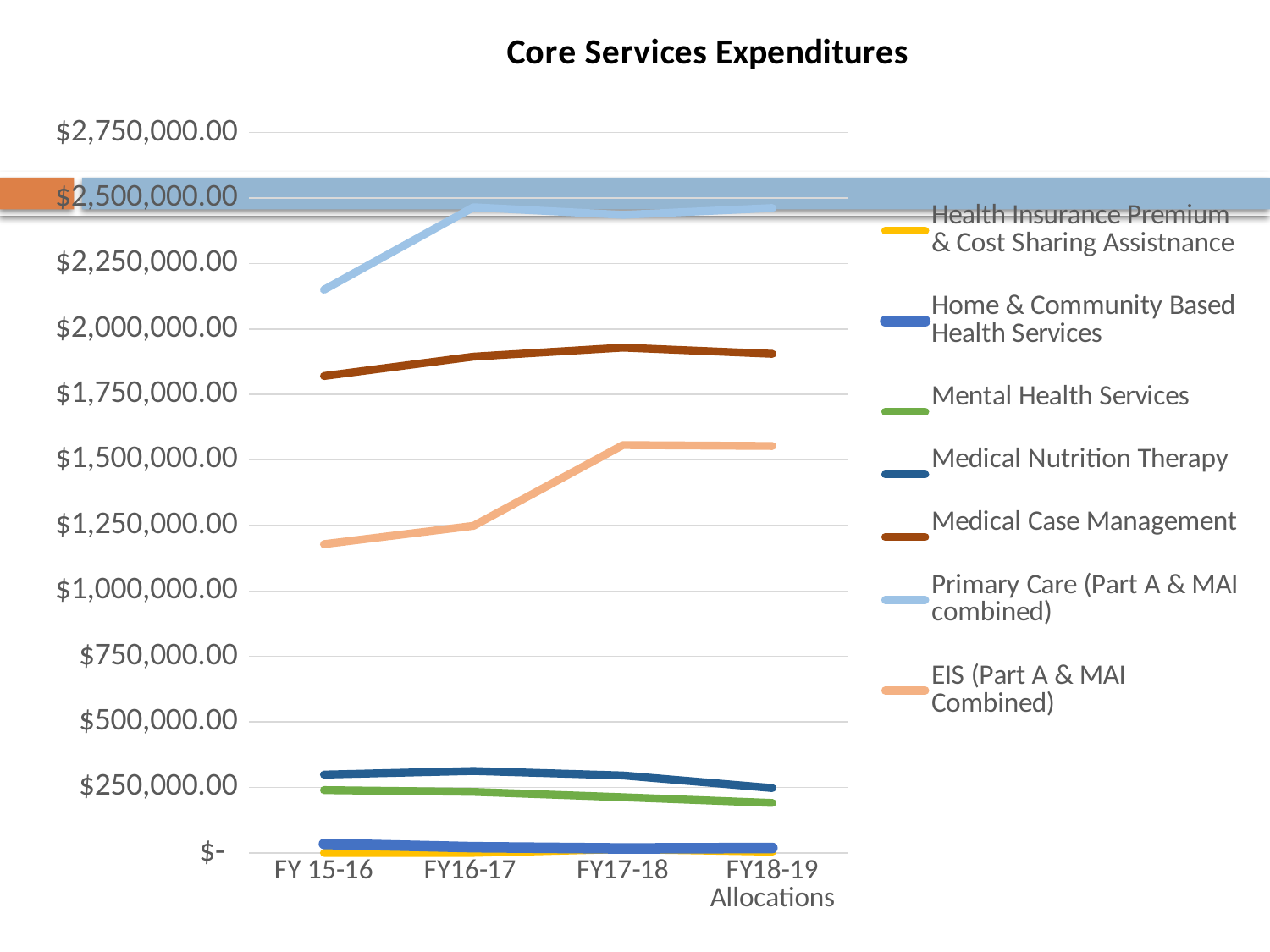
How many series does the legend list? 7 Does the EIS (Part A & MAI Combined) line rise or fall from FY 15-16 to FY18-19 Allocations? rise Which series has the highest value in FY 15-16? Primary Care (Part A & MAI combined) Is the value for EIS (Part A & MAI Combined) in FY17-18 greater or less than $1,500,000.00? greater Is the value for EIS (Part A & MAI Combined) in FY 15-16 greater or less than $1,250,000.00? less Does the Mental Health Services line rise or fall from FY 15-16 to FY18-19 Allocations? fall How many fiscal-year categories are shown on the x axis? 4 What is the title of the chart? Core Services Expenditures Is the value for Medical Case Management in FY17-18 greater or less than $1,750,000.00? greater What kind of chart is shown on the slide? line chart In FY 15-16, which is larger: Medical Nutrition Therapy or Mental Health Services? Medical Nutrition Therapy